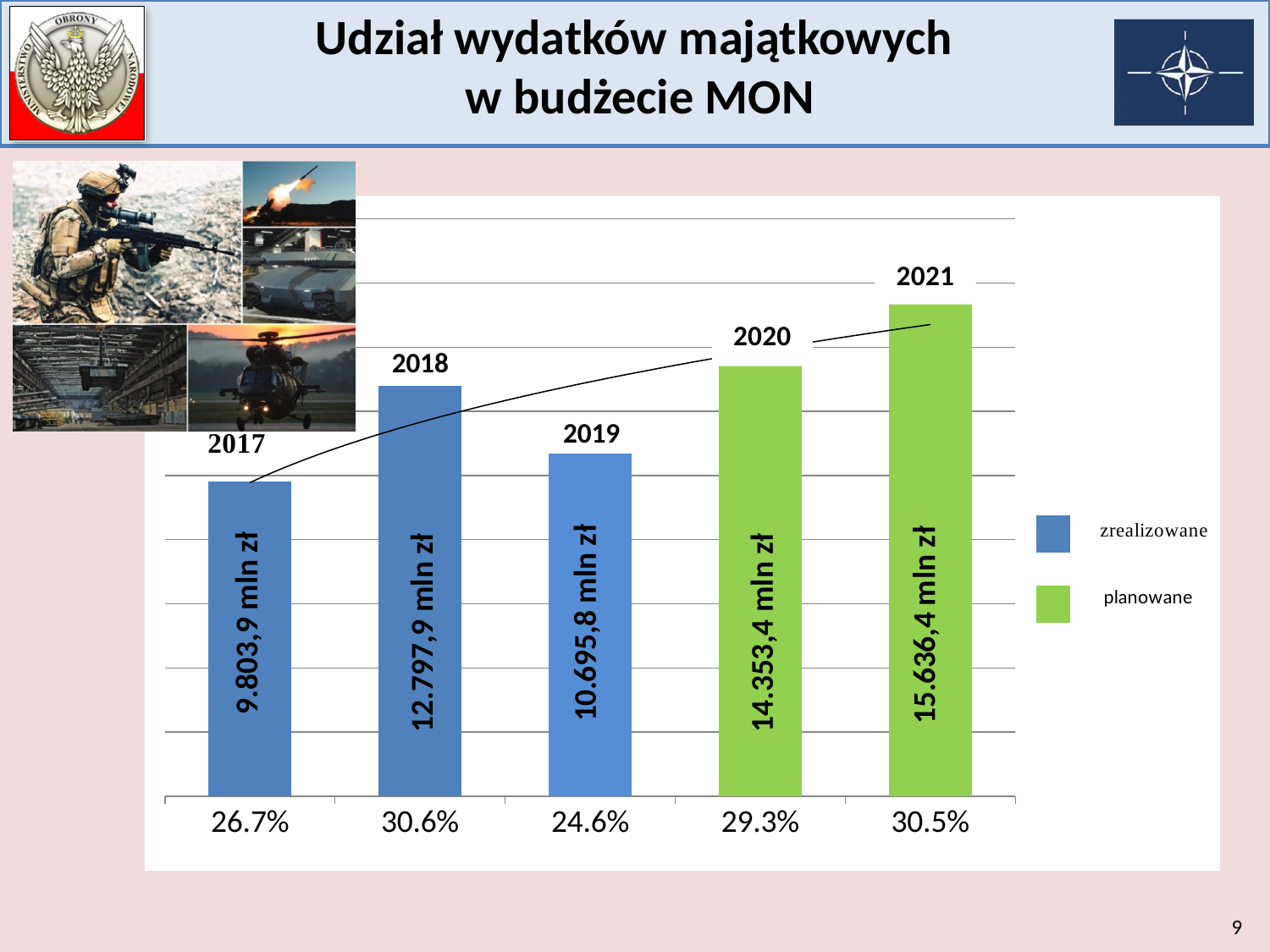
Which year has the lowest bar? 2017 What is the value shown on the bar for 2017? 9.803,9 mln zł Which year has the highest bar? 2021 Which year has the larger value, 2018 or 2019? 2018 How many years are shown in the chart? 5 What kind of chart is shown on the slide? bar chart What percentage is shown on the x axis under the 2019 bar? 24.6% Which legend entry corresponds to the green bars? planowane How many series does the legend list? 2 What is the value shown on the bar for 2020? 14.353,4 mln zł Do the values rise or fall from 2019 to 2021? rise What is the difference between the values for 2021 and 2020? 1.283,0 mln zł